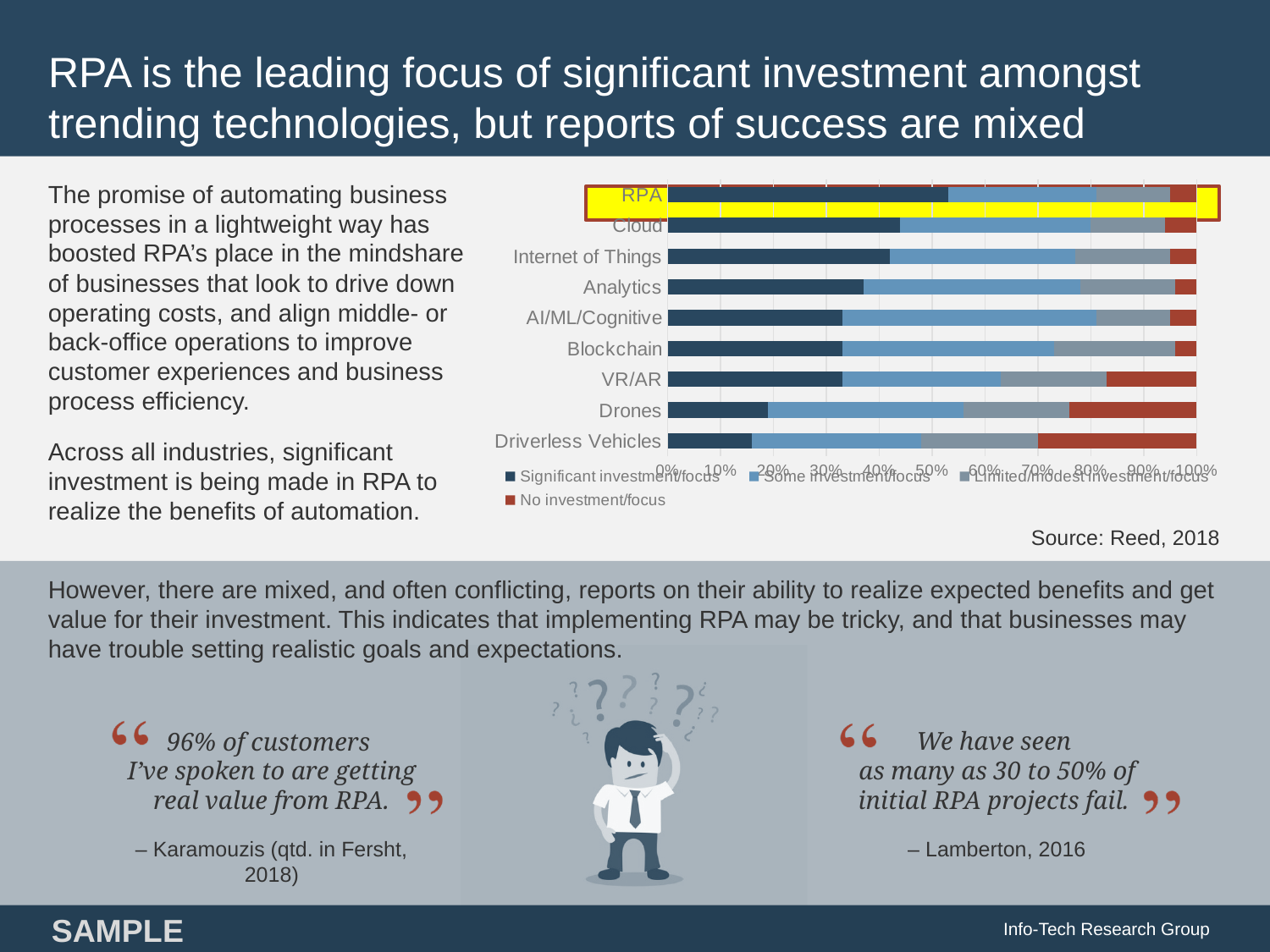
Which has a larger 'No investment/focus' segment, Drones or Analytics? Drones How many technology categories are plotted in the chart? 9 How many series does the chart legend list? 4 Which category's bar is highlighted in yellow on the chart? RPA Which technology has the largest 'No investment/focus' segment? Driverless Vehicles Is the 'Significant investment/focus' value for Driverless Vehicles greater or less than 20%? less Which technology has the largest 'Significant investment/focus' segment? RPA Which has a larger 'Significant investment/focus' segment, RPA or Cloud? RPA What kind of chart is shown on the slide? Stacked bar chart Is the 'Significant investment/focus' value for RPA greater or less than 40%? greater Is the 'Significant investment/focus' value for Drones greater or less than 30%? less Which technology has the smallest 'Significant investment/focus' segment? Driverless Vehicles